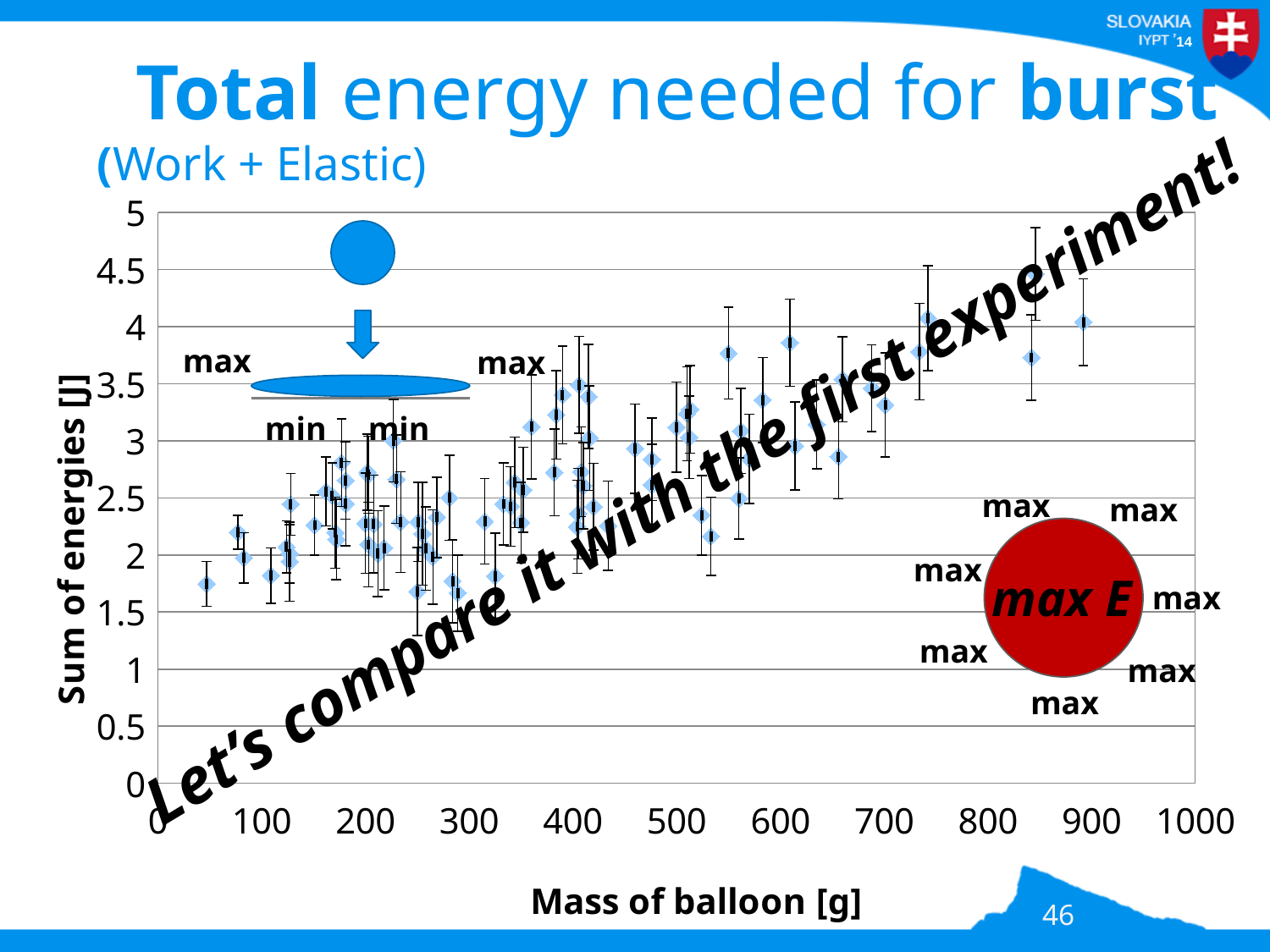
Is the plotted value at the smallest balloon mass (around 50 g) greater or less than 2? less What is the maximum value shown on the y axis? 5 Is the plotted value at about 740 g greater or less than 3.5? greater What is the label of the y axis? Sum of energies [J] What kind of chart is shown on the slide? scatter chart Is the lowest plotted energy value greater or less than 2? less Which is larger: the plotted energy at about 50 g or the plotted energy at about 740 g? about 740 g What is the label of the x axis? Mass of balloon [g] Do the plotted energy values generally rise or fall as the mass of the balloon increases? rise